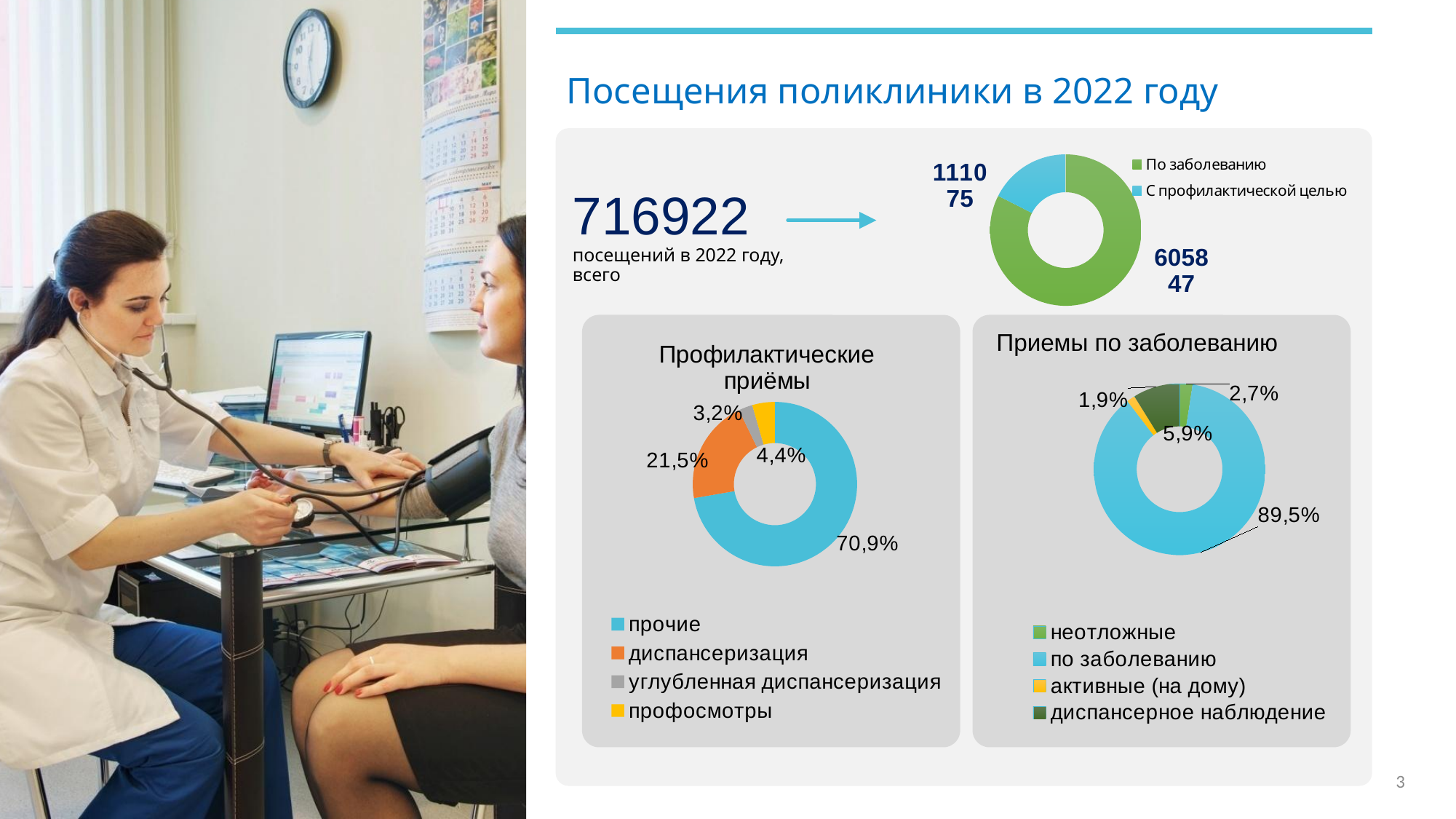
What type of chart is the 'Приемы по заболеванию' chart? Donut (pie) chart In the 'Приемы по заболеванию' chart, what share does 'диспансерное наблюдение' have? 5,9% In the 'Профилактические приёмы' chart, what is the difference between the shares of 'прочие' and 'диспансеризация'? 49,4% In the top donut chart, what is the value for 'По заболеванию'? 605847 In the 'Профилактические приёмы' chart, which category has the smallest share? углубленная диспансеризация In the 'Профилактические приёмы' chart, what share does 'прочие' have? 70,9% In the 'Профилактические приёмы' chart, what share does 'диспансеризация' have? 21,5% In the top donut chart, which category is larger: 'По заболеванию' or 'С профилактической целью'? По заболеванию In the top donut chart, what is the value for 'С профилактической целью'? 111075 In the 'Приемы по заболеванию' chart, what share does 'по заболеванию' have? 89,5% How many categories does the legend of the 'Профилактические приёмы' chart list? 4 In the 'Приемы по заболеванию' chart, which category has the smallest share? активные (на дому)